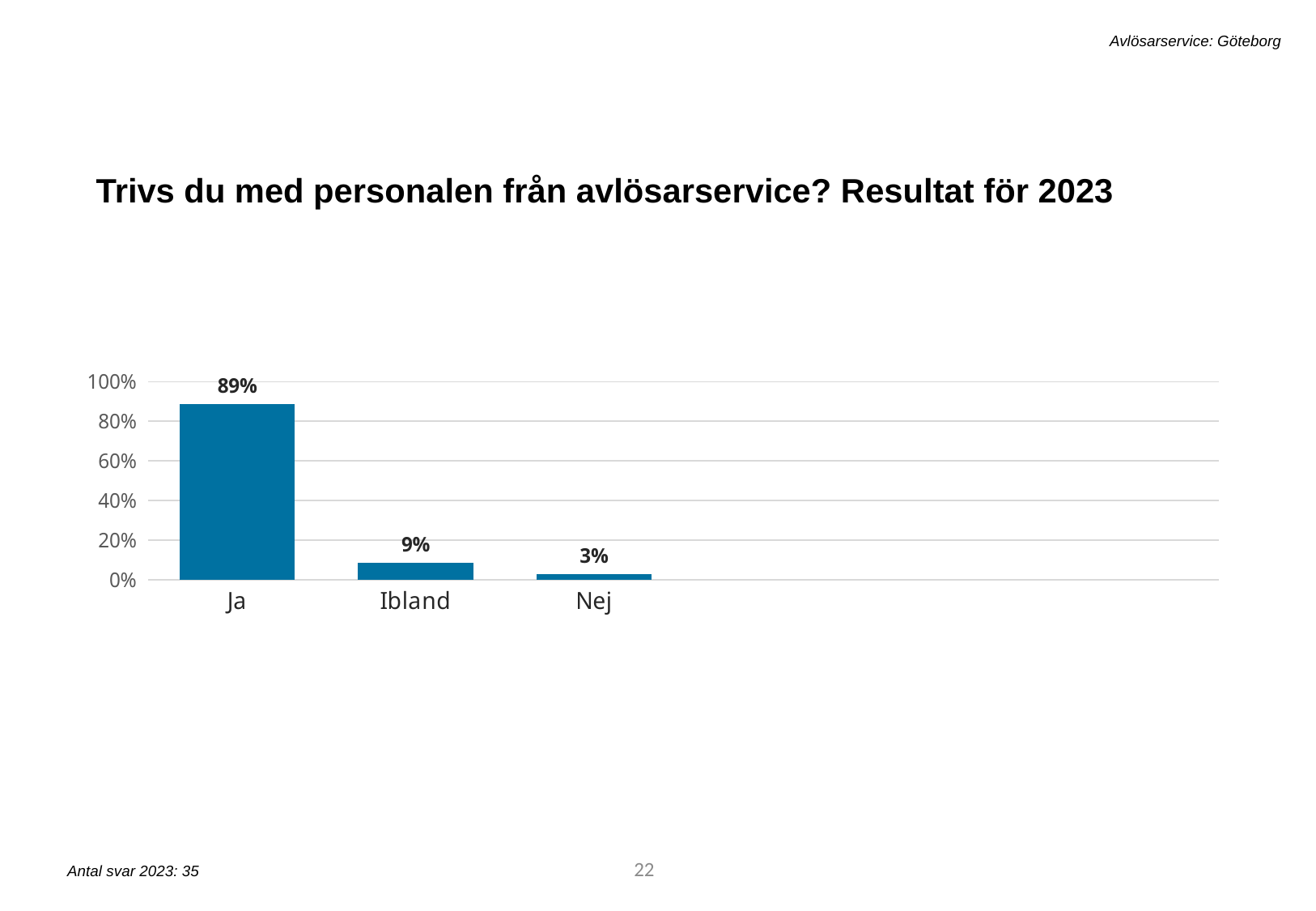
What is the title of the chart? Trivs du med personalen från avlösarservice? Resultat för 2023 What kind of chart is shown on the slide? bar chart How many categories are shown on the x axis? 3 What is the value for Ibland? 9% Which category has the lowest value? Nej Is the value for Ja greater or less than 80%? greater What is the value for Ja? 89% Which is larger, the value for Ibland or the value for Nej? Ibland What is the difference between the values for Ibland and Nej? 6% Which category has the highest value? Ja What is the difference between the values for Ja and Ibland? 80% What is the value for Nej? 3%